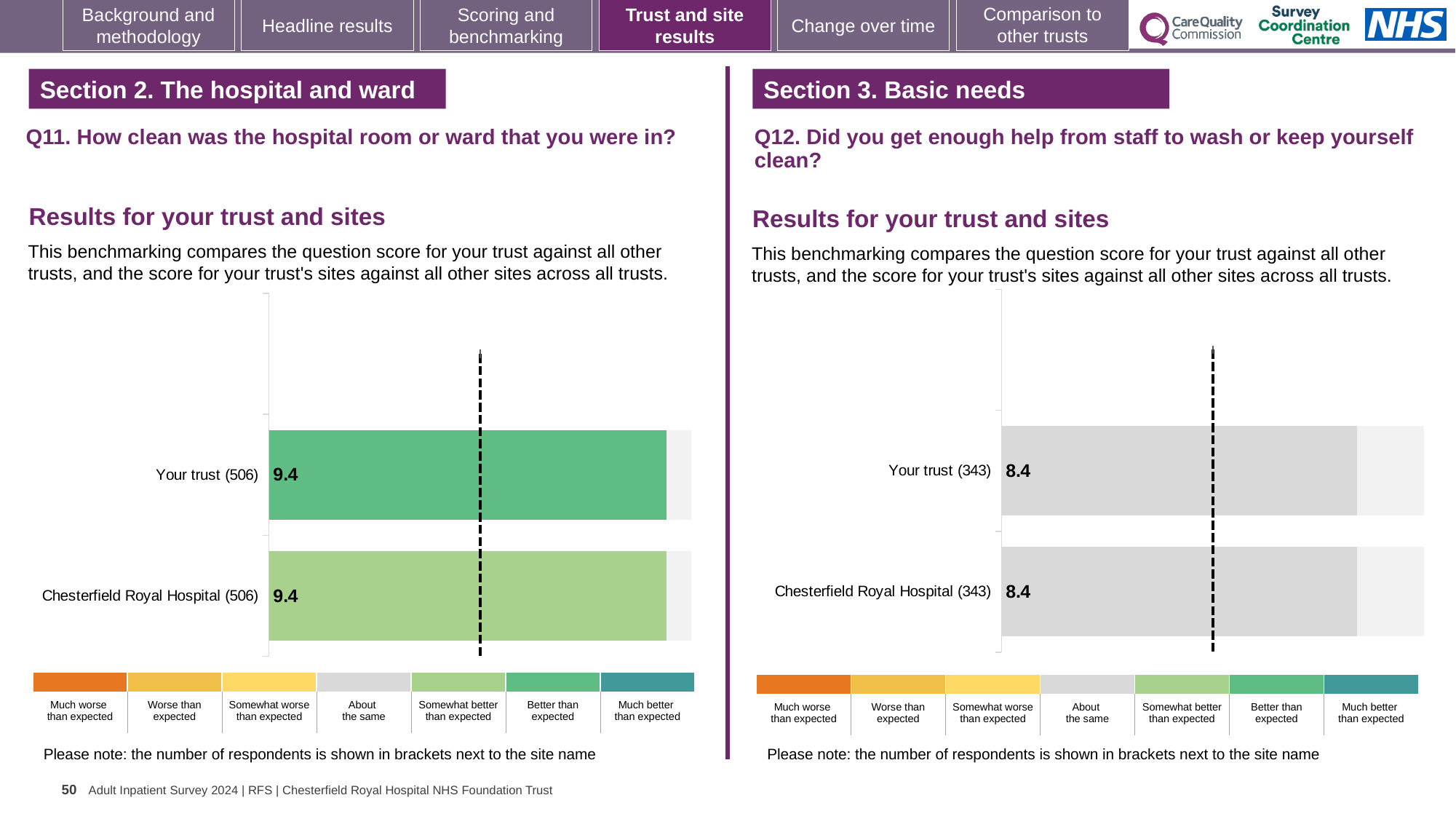
What kind of chart is used for the Q11 results on the left? Bar chart On the Q12 chart (right), what is the score for Chesterfield Royal Hospital (343)? 8.4 How many bars are plotted on the Q11 chart (left)? 2 On the Q12 chart (right), what is the score for Your trust (343)? 8.4 On the Q11 chart (left), which benchmark category does the colour of the Your trust bar correspond to in the legend? Better than expected On the Q12 chart (right), which benchmark category does the grey colour of the bars correspond to in the legend? About the same On the Q11 chart (left), how many respondents are shown in brackets for Your trust? 506 On the Q11 chart (left), what is the difference between the score for Your trust and the score for Chesterfield Royal Hospital? 0 On the Q11 chart (left), what is the score for Chesterfield Royal Hospital (506)? 9.4 On the Q11 chart (left), what is the score for Your trust (506)? 9.4 How many bars are plotted on the Q12 chart (right)? 2 On the Q12 chart (right), what is the difference between the score for Your trust and the score for Chesterfield Royal Hospital? 0